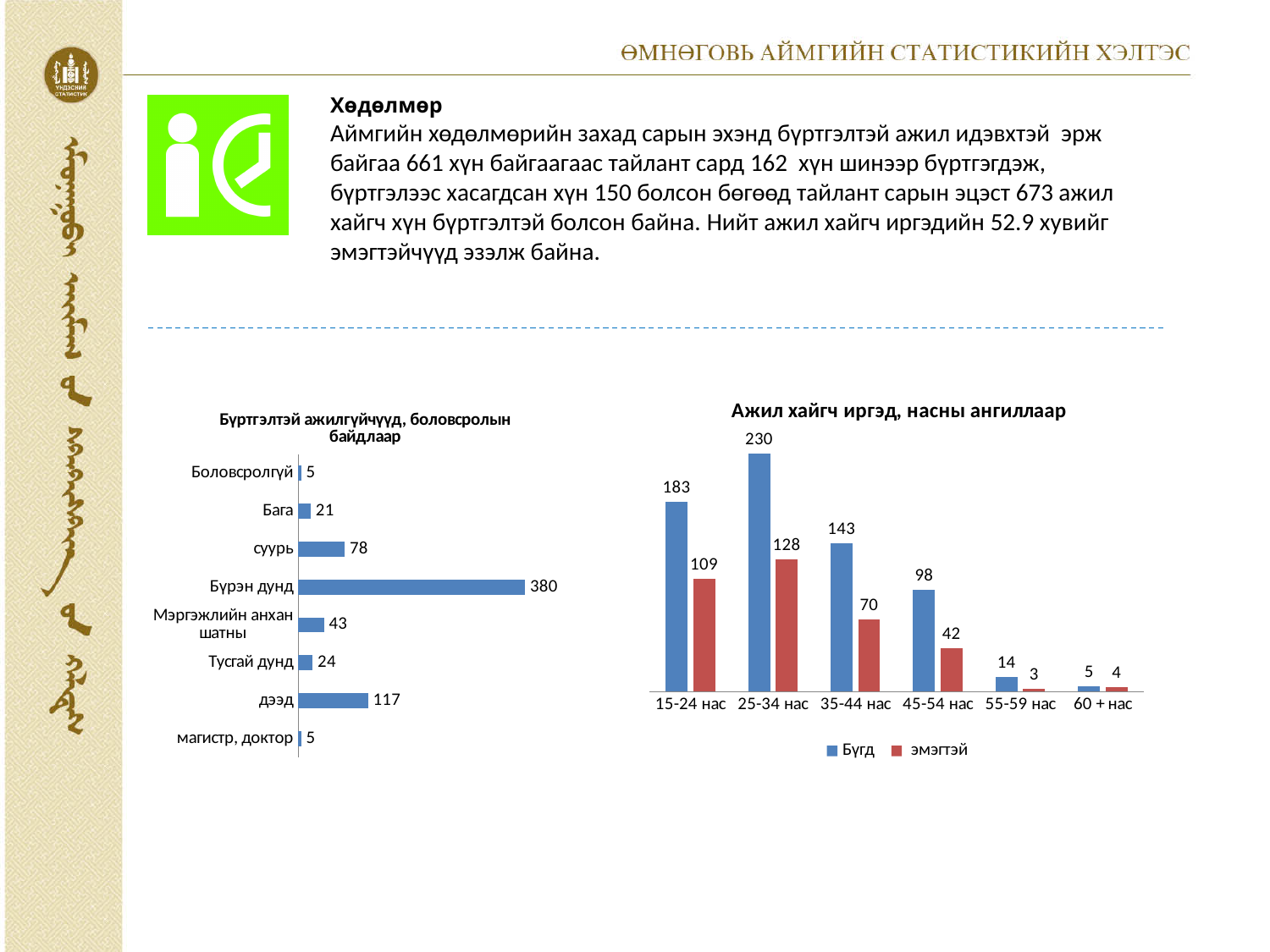
In the chart 'Ажил хайгч иргэд, насны ангиллаар', what is the Бүгд value for 25-34 нас? 230 In the chart 'Бүртгэлтэй ажилгүйчүүд, боловсролын байдлаар', how many categories are shown? 8 In the chart 'Бүртгэлтэй ажилгүйчүүд, боловсролын байдлаар', what is the value for Бүрэн дунд? 380 In the chart 'Ажил хайгч иргэд, насны ангиллаар', which is larger: the Бүгд value for 45-54 нас or the эмэгтэй value for 25-34 нас? эмэгтэй value for 25-34 нас In the chart 'Ажил хайгч иргэд, насны ангиллаар', how many series does the legend list? 2 What type of chart is 'Бүртгэлтэй ажилгүйчүүд, боловсролын байдлаар'? Bar chart In the chart 'Бүртгэлтэй ажилгүйчүүд, боловсролын байдлаар', which category has the highest value? Бүрэн дунд In the chart 'Ажил хайгч иргэд, насны ангиллаар', what is the эмэгтэй value for 35-44 нас? 70 In the chart 'Бүртгэлтэй ажилгүйчүүд, боловсролын байдлаар', what is the difference between суурь and Бага? 57 In the chart 'Ажил хайгч иргэд, насны ангиллаар', what is the difference between the Бүгд and эмэгтэй values for 15-24 нас? 74 In the chart 'Бүртгэлтэй ажилгүйчүүд, боловсролын байдлаар', what is the value for дээд? 117 In the chart 'Ажил хайгч иргэд, насны ангиллаар', which age group has the lowest Бүгд value? 60 + нас